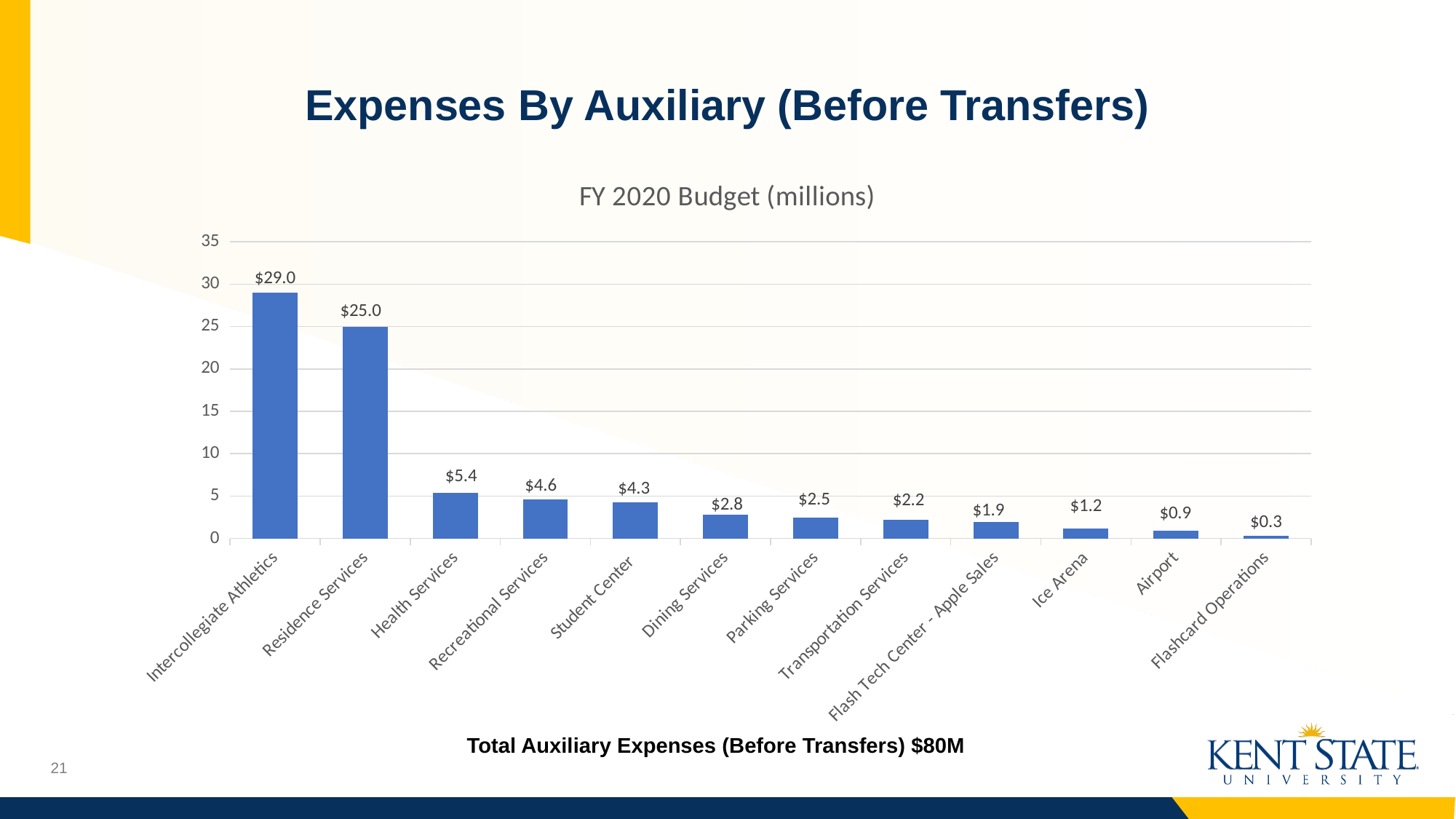
Which category has the lowest FY 2020 budget? Flashcard Operations What is the FY 2020 budget value for Ice Arena? $1.2 Which is larger, the value for Dining Services or the value for Parking Services? Dining Services How many categories are shown on the x axis of the chart? 12 What kind of chart is shown on the slide? Bar chart What is the title of the chart? FY 2020 Budget (millions) Do the values rise or fall moving from left to right along the x axis? Fall What is the FY 2020 budget value for Transportation Services? $2.2 Which category has the highest FY 2020 budget? Intercollegiate Athletics What is the difference between the values for Intercollegiate Athletics and Residence Services? $4.0 What is the FY 2020 budget value for Health Services? $5.4 Is the value for Residence Services greater or less than 20? greater